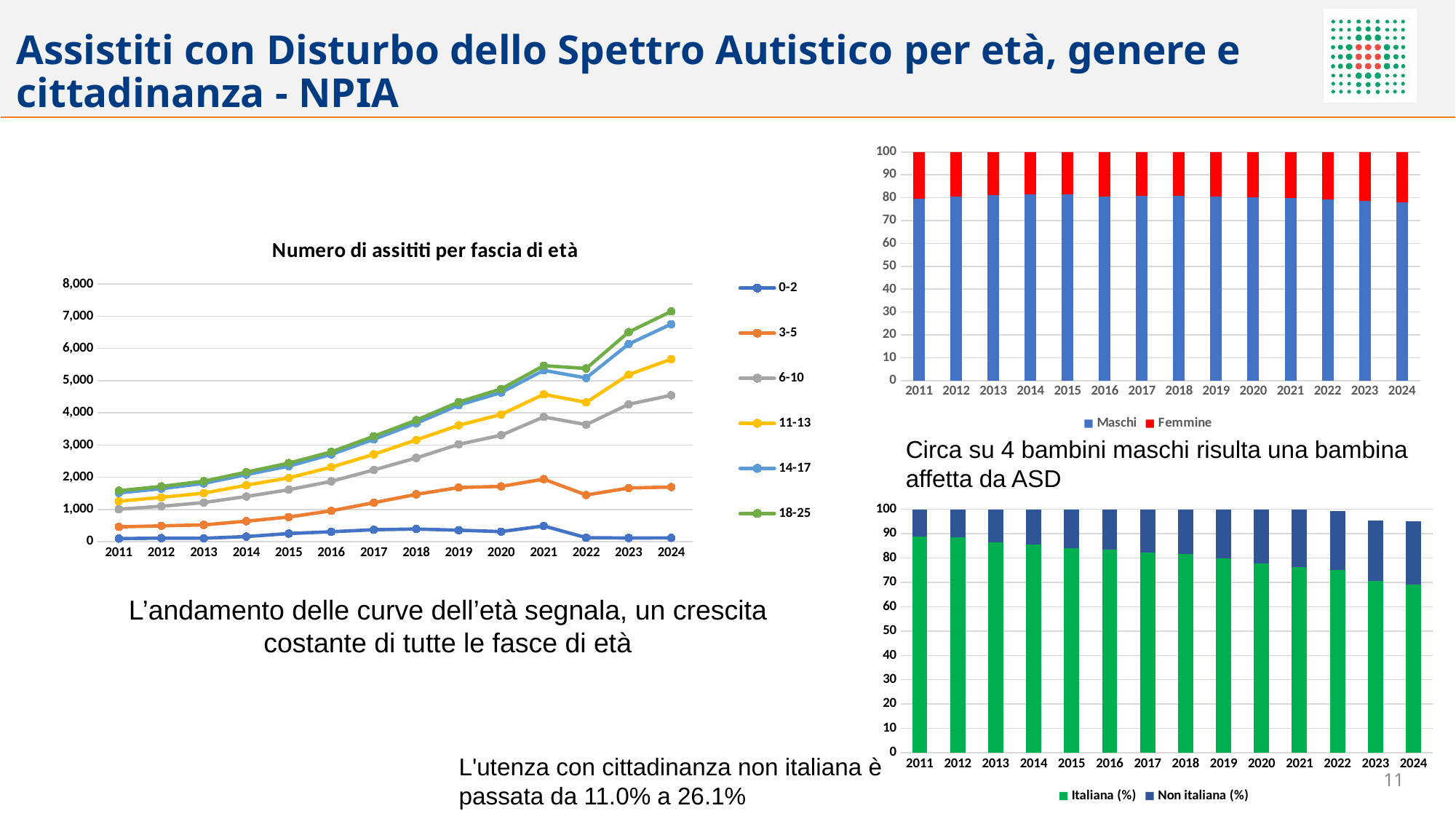
In the 'Numero di assititi per fascia di età' chart, which age group has the lowest value in 2024? 0-2 How many series does the legend of the 'Numero di assititi per fascia di età' chart list? 6 In the bottom-right chart (Italiana/Non italiana), is the value for Italiana (%) in 2024 greater or less than 80? less In the top-right chart (Maschi/Femmine), which series is larger in 2024, Maschi or Femmine? Maschi In the top-right chart (Maschi/Femmine), is the value for Femmine in 2024 greater or less than 30? less In the 'Numero di assititi per fascia di età' chart, is the value for 0-2 in 2024 greater or less than 1,000? less In the 'Numero di assititi per fascia di età' chart, does the 18-25 series rise or fall from 2011 to 2024? rise How many years are plotted on the x axis of the 'Numero di assititi per fascia di età' chart? 14 What kind of chart is the 'Numero di assititi per fascia di età' chart? line chart In the bottom-right chart (Italiana/Non italiana), does the Italiana (%) series rise or fall from 2011 to 2024? fall